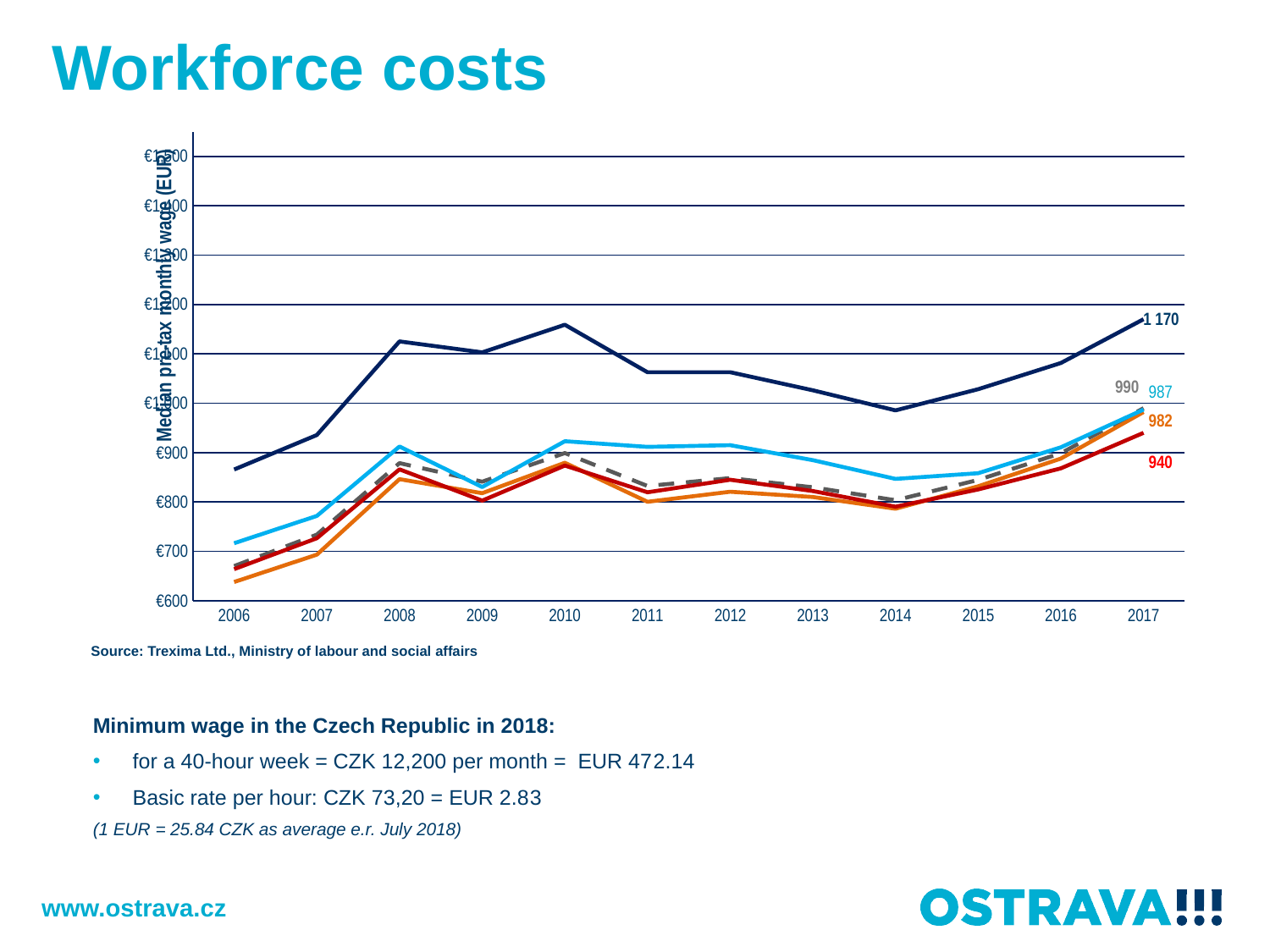
What is the label on the y axis of the chart? Median pre-tax monthly wage (EUR) Which line has the lowest value in 2017? The red line (940) What is the 2017 value labelled on the dark navy line? 1 170 What is the difference between the 2017 values of the dark navy line (1 170) and the red line (940)? 230 What is the 2017 value labelled on the orange line? 982 What is the 2017 value labelled on the red line? 940 Is the value of the dark navy line in 2010 greater or less than €1,100? greater How many years are shown along the x axis of the chart? 12 Which line has the highest value in 2017? The dark navy line (1 170) What kind of chart is shown on the slide? Line chart How many lines are plotted on the chart? 5 In 2017, which is larger: the grey dashed line's value or the red line's value? The grey dashed line (990)